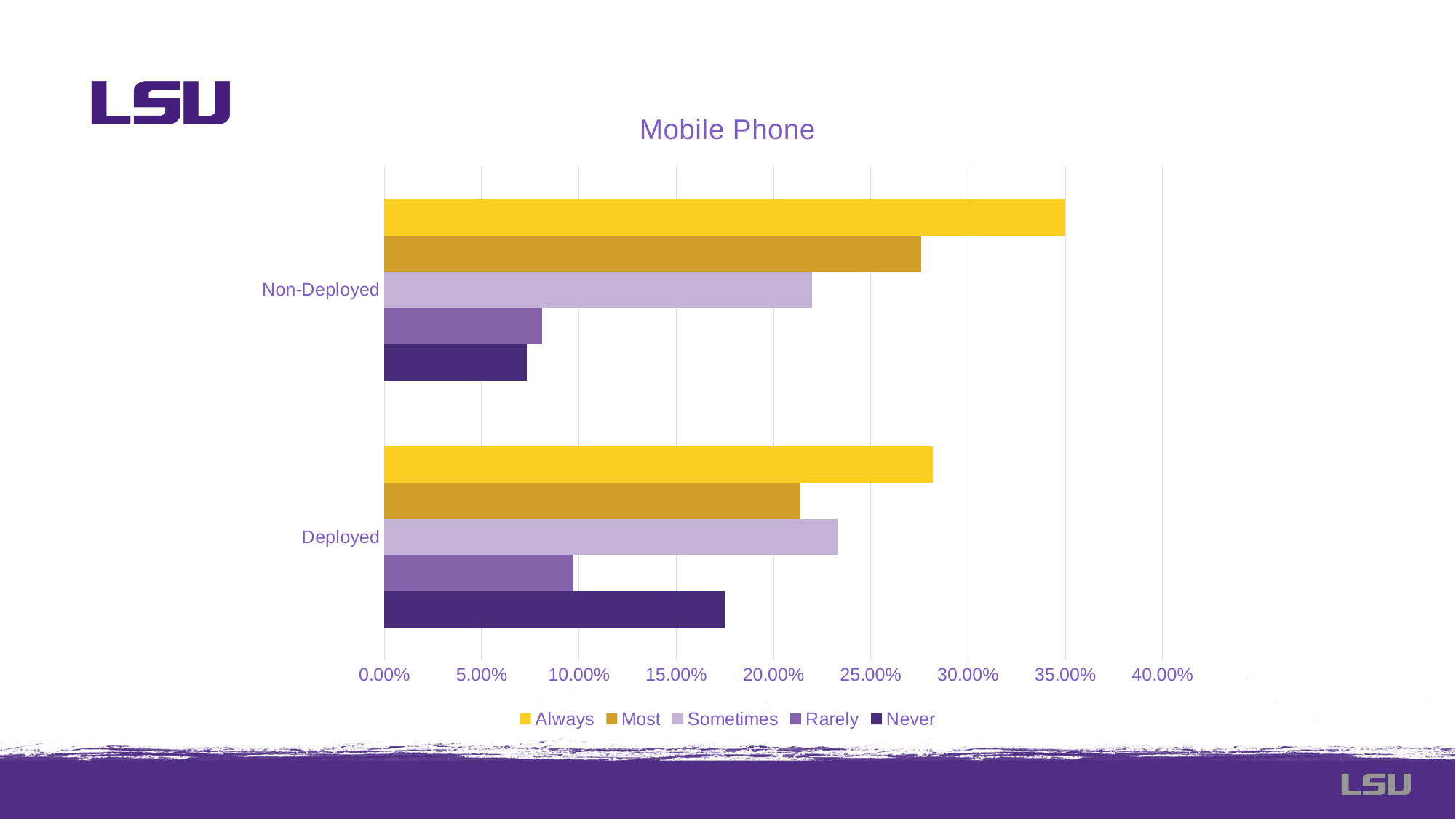
Which series is shown in the darkest purple colour in the legend? Never What is the title of the chart? Mobile Phone Which series has the highest value for Non-Deployed? Always Is the Most value for Non-Deployed greater or less than 25.00%? greater Which series has the lowest value for Deployed? Rarely How many categories are shown on the vertical axis? 2 How many series does the legend list? 5 Which is larger, the Never value for Deployed or the Never value for Non-Deployed? Deployed Is the Always value for Deployed greater or less than 30.00%? less Is the Never value for Deployed greater or less than 15.00%? greater What kind of chart is shown on the slide? bar chart